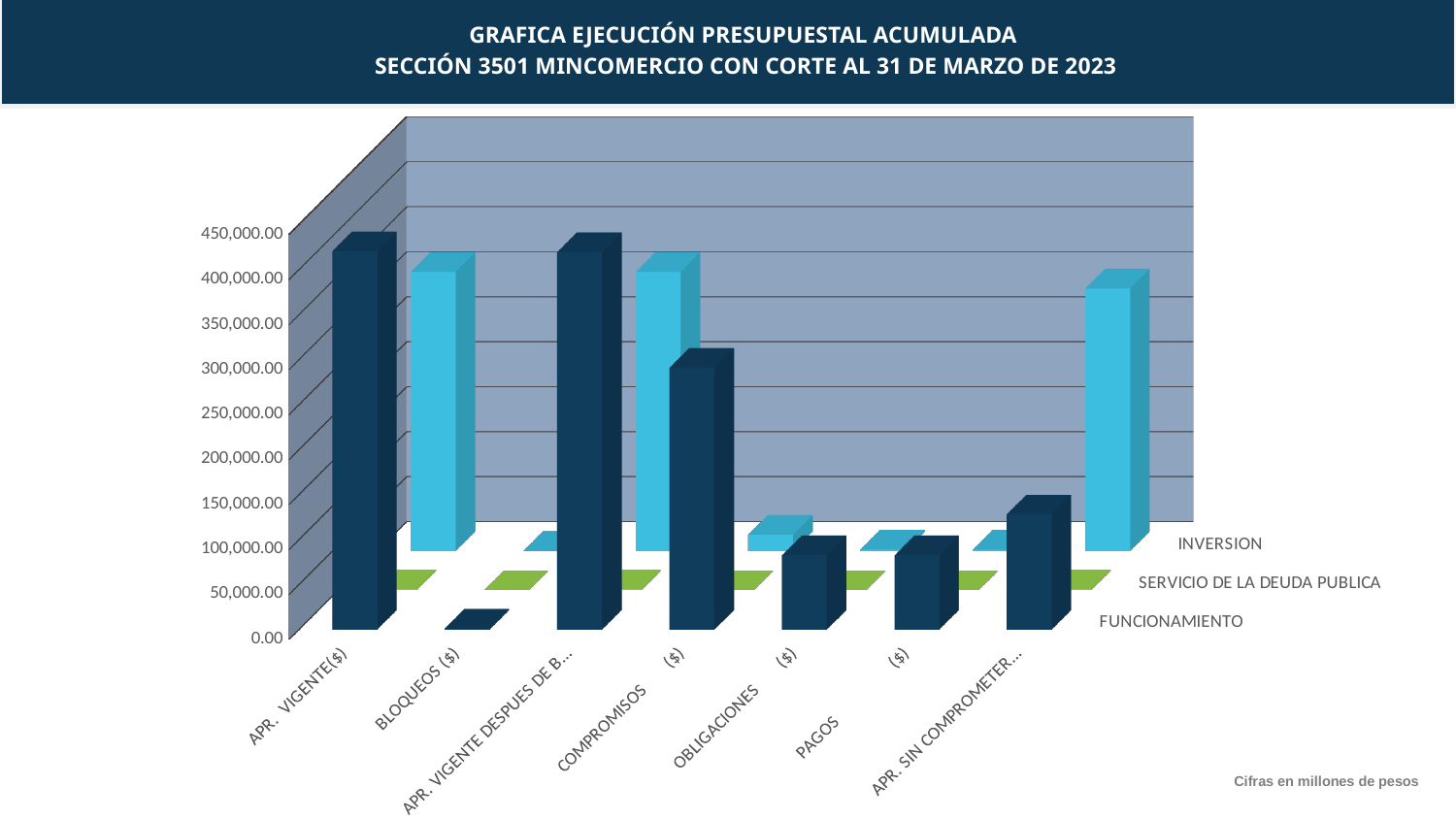
How many categories are shown along the x axis? 7 Is the FUNCIONAMIENTO value for COMPROMISOS ($) greater or less than 200,000.00? greater For the FUNCIONAMIENTO series, which is larger: COMPROMISOS ($) or OBLIGACIONES ($)? COMPROMISOS ($) What unit note is printed at the bottom right of the chart? Cifras en millones de pesos For the FUNCIONAMIENTO series, which is larger: APR. SIN COMPROMETER... or PAGOS ($)? APR. SIN COMPROMETER... Is the FUNCIONAMIENTO value for APR. SIN COMPROMETER... greater or less than 250,000.00? less What kind of chart is shown on the slide? bar chart Which category has the lowest FUNCIONAMIENTO value? BLOQUEOS ($) Is the FUNCIONAMIENTO value for APR. VIGENTE($) greater or less than 300,000.00? greater